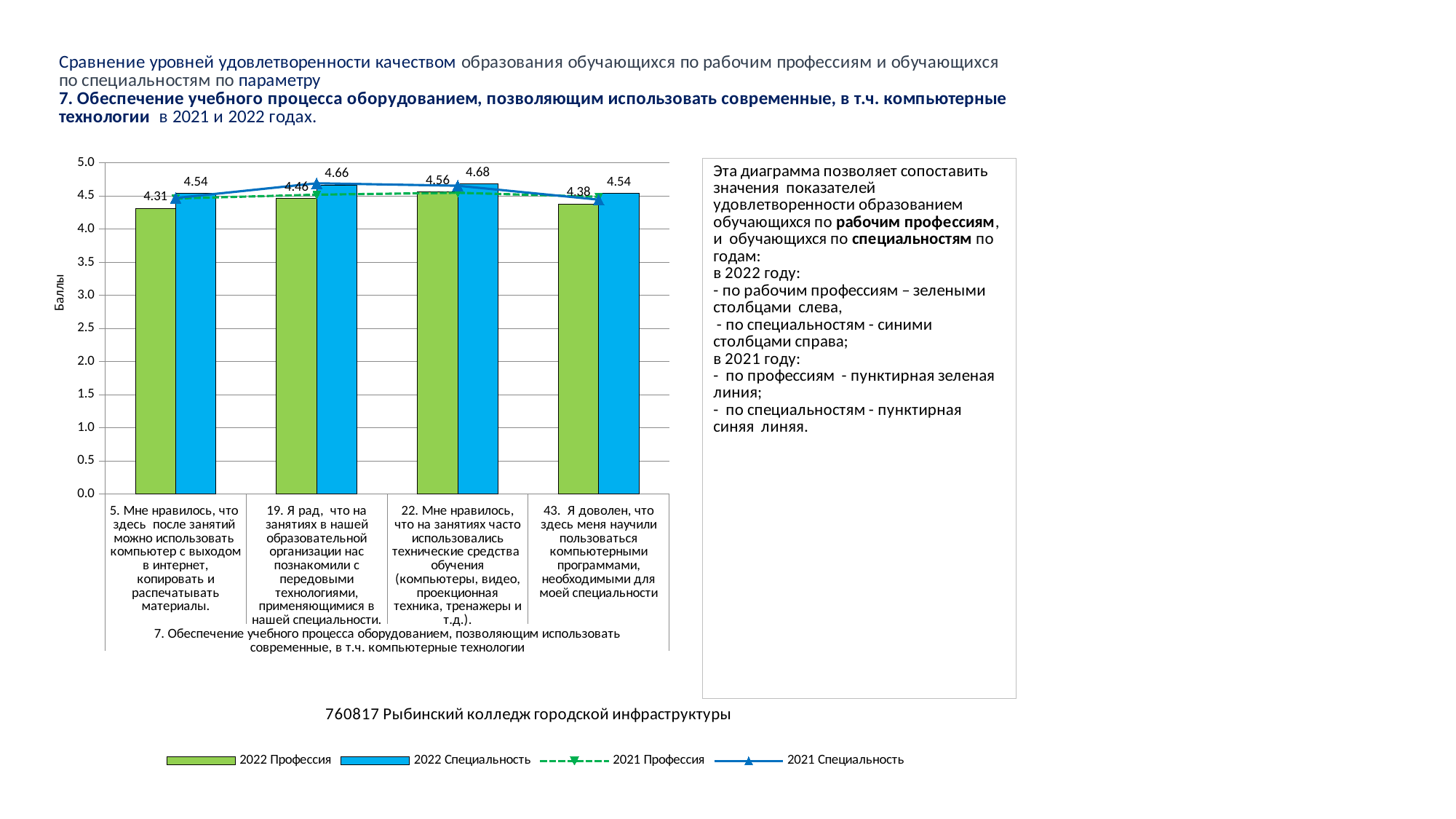
What is the value of the 2022 Специальность bar for category 19 ("Я рад, что на занятиях в нашей образовательной организации нас познакомили с передовыми технологиями...")? 4.66 What is the label of the vertical axis of the chart? Баллы How many series does the chart legend list? 4 What is the value of the 2022 Профессия bar for category 5 ("Мне нравилось, что здесь после занятий можно использовать компьютер...")? 4.31 Which category has the lowest 2022 Профессия bar? 5. Мне нравилось, что здесь после занятий можно использовать компьютер с выходом в интернет What is the difference between the 2022 Специальность and 2022 Профессия bars for category 5? 0.23 What is the value of the 2022 Специальность bar for category 22 ("Мне нравилось, что на занятиях часто использовались технические средства обучения...")? 4.68 How many categories are shown on the x axis of the chart? 4 For category 43, which 2022 bar is larger: Профессия or Специальность? Специальность What is the value of the 2022 Профессия bar for category 43 ("Я доволен, что здесь меня научили пользоваться компьютерными программами...")? 4.38 Is the 2022 Профессия value for category 5 greater or less than 4.5? less Which category has the highest 2022 Профессия bar? 22. Мне нравилось, что на занятиях часто использовались технические средства обучения